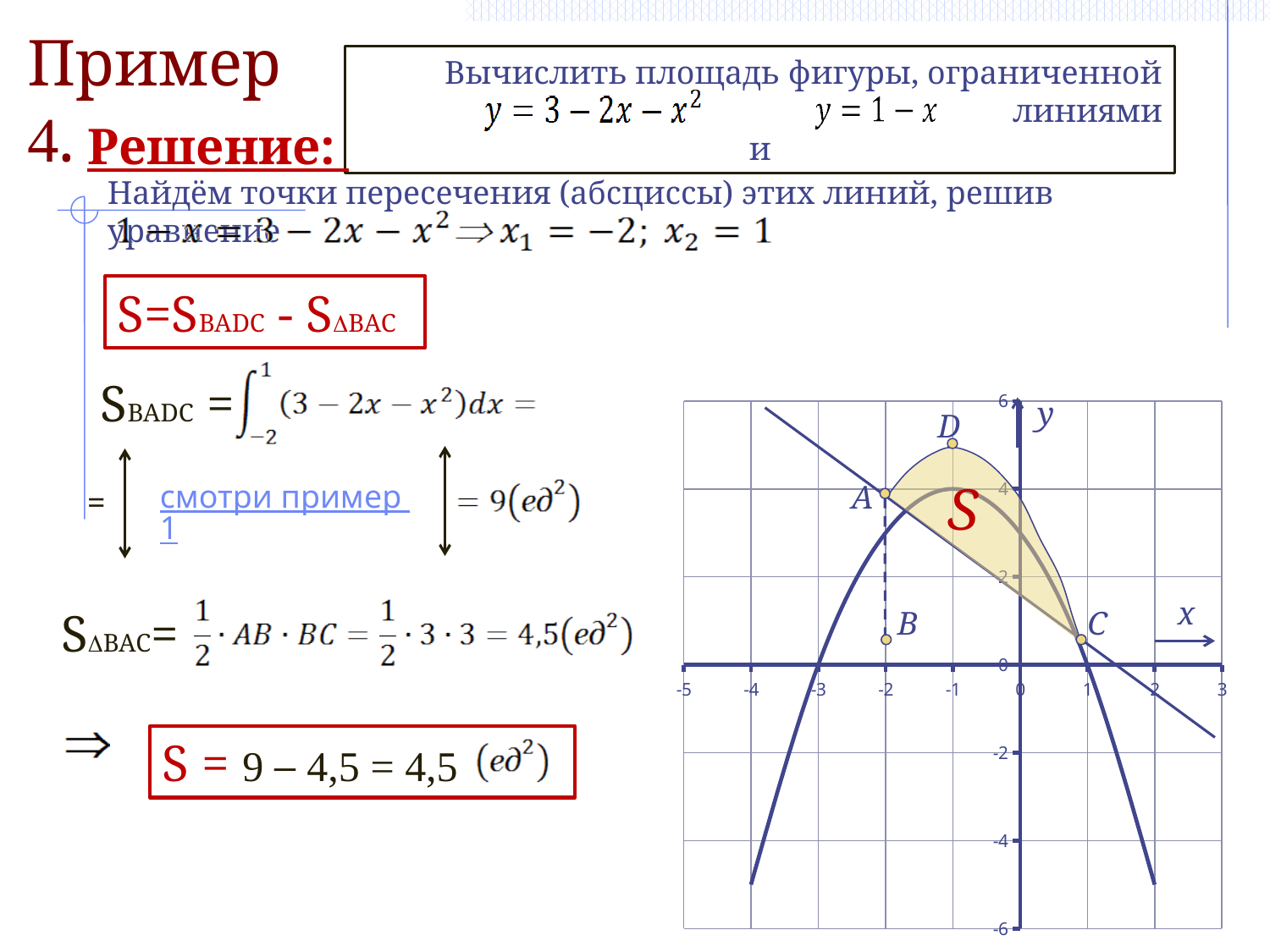
What is the largest value labeled on the x axis? 3 Is the y-value of point A greater or less than 2? greater What letter labels the shaded region on the graph? S Does the straight line rise or fall as x increases? fall How many curves are plotted on the graph? 2 At which x-axis tick does point C lie? 1 At which x-axis tick does point A lie? -2 What is the smallest value labeled on the y axis? -6 What kind of chart is shown on the slide? line graph (function plot) How many labeled points (A, B, C, D) are marked on the graph? 4 What are the labels of the horizontal and vertical axes? x and y Which labeled point on the graph is the highest? D